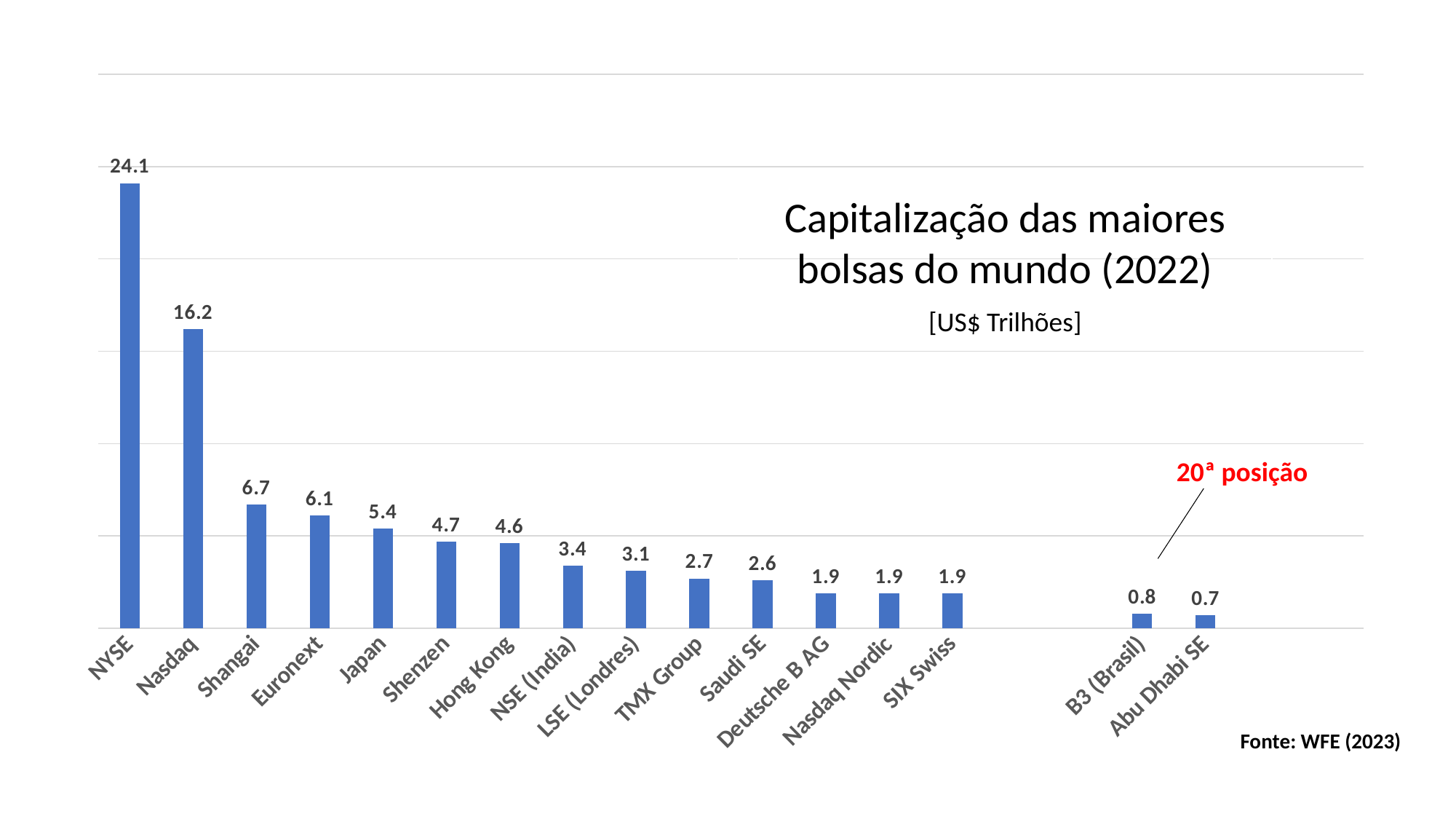
What is the value for B3 (Brasil)? 0.8 What is the difference between the values for Shangai and Euronext? 0.6 How many exchanges are shown in the chart? 16 Which exchange has the lowest capitalization? Abu Dhabi SE Which exchange has the highest capitalization? NYSE What is the value for Hong Kong? 4.6 Which exchange is marked with the annotation "20ª posição"? B3 (Brasil) What is the value for NYSE? 24.1 What is the difference between the values for NYSE and Nasdaq? 7.9 What is the title of the chart? Capitalização das maiores bolsas do mundo (2022) What kind of chart is shown on the slide? Bar chart Which is larger, the value for Japan or the value for Shenzen? Japan